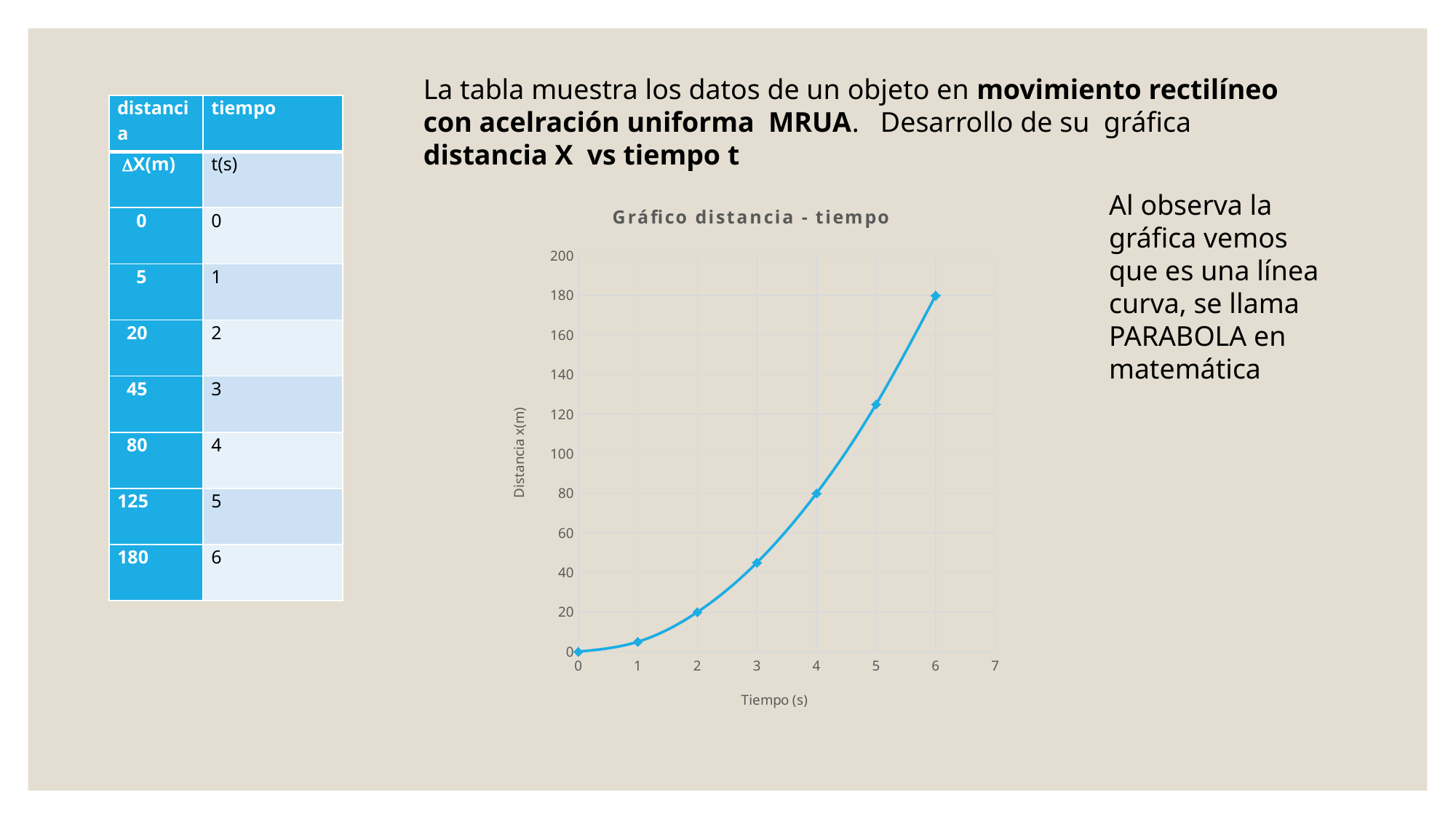
At which time is the distance highest? 6 What is the title of the chart? Gráfico distancia - tiempo Is the distance at time 5 s greater or less than 100? greater At which time is the distance lowest? 0 What type of chart is shown on the slide? line chart What is the label of the y axis of the chart? Distancia x(m) What is the distance value at time 4 s? 80 What is the distance value at time 2 s? 20 Do the distance values rise or fall as time increases? rise What is the distance value at time 6 s? 180 How many data points are plotted on the chart? 7 What is the difference between the distance at 6 s and the distance at 4 s? 100